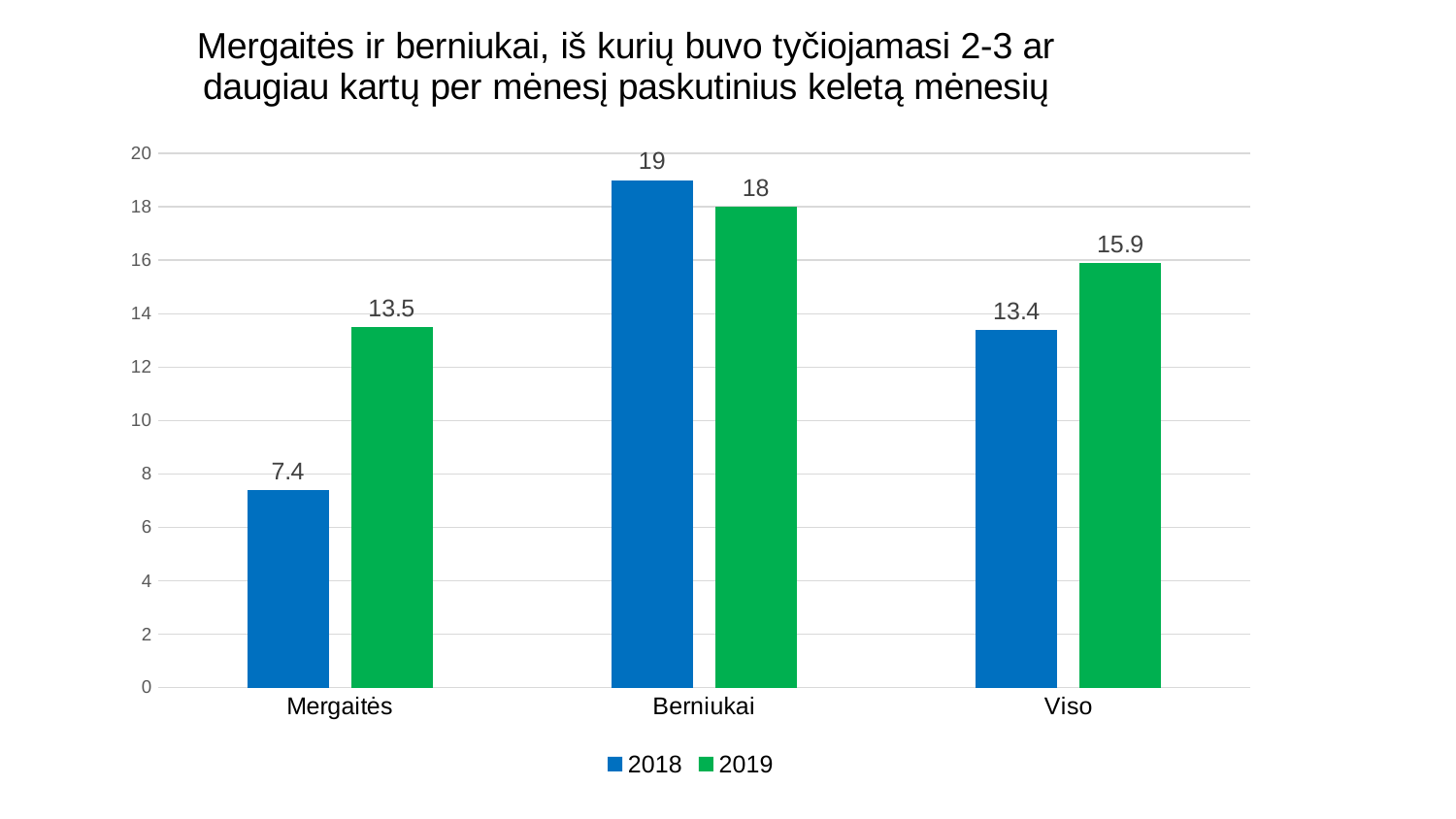
What is the value for Viso in 2019? 15.9 Is the value for Berniukai in 2018 greater or less than 16? greater How many categories are shown on the x axis? 3 Which category has the highest value in the 2018 series? Berniukai Which category has the lowest value in the 2019 series? Mergaitės What is the difference between the 2018 and 2019 values for Berniukai? 1 What is the value for Mergaitės in 2018? 7.4 Which is larger for Viso: the 2018 value or the 2019 value? 2019 What is the difference between the 2019 and 2018 values for Mergaitės? 6.1 How many series does the legend list? 2 What kind of chart is shown on the slide? Bar chart What is the value for Berniukai in 2019? 18